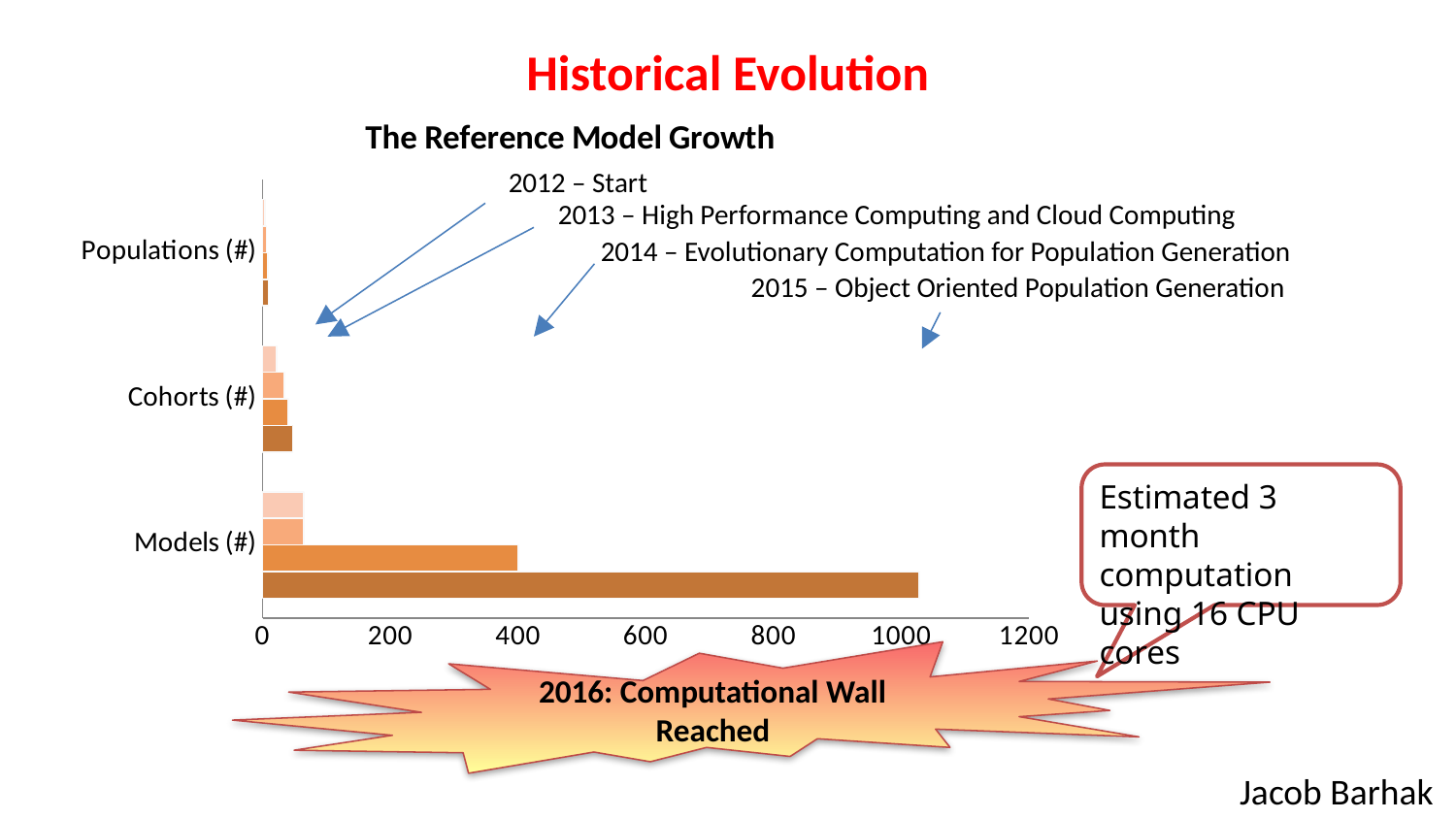
What kind of chart is shown on the slide? bar chart Which category has the longest bar in the chart? Models (#) What is the title of the chart? The Reference Model Growth How many bars are drawn for each category in the chart? 4 Is the second-longest bar for Models (#) greater or less than 600? less Are all the bars for Cohorts (#) greater or less than 200? less How many categories are shown on the vertical axis of the chart? 3 Within the Models (#) category, do the bars get longer or shorter going from the top bar to the bottom bar? longer Is the longest bar for Models (#) greater or less than 800? greater What is the highest value shown on the horizontal axis of the chart? 1200 Which category has a larger longest bar, Models (#) or Cohorts (#)? Models (#)